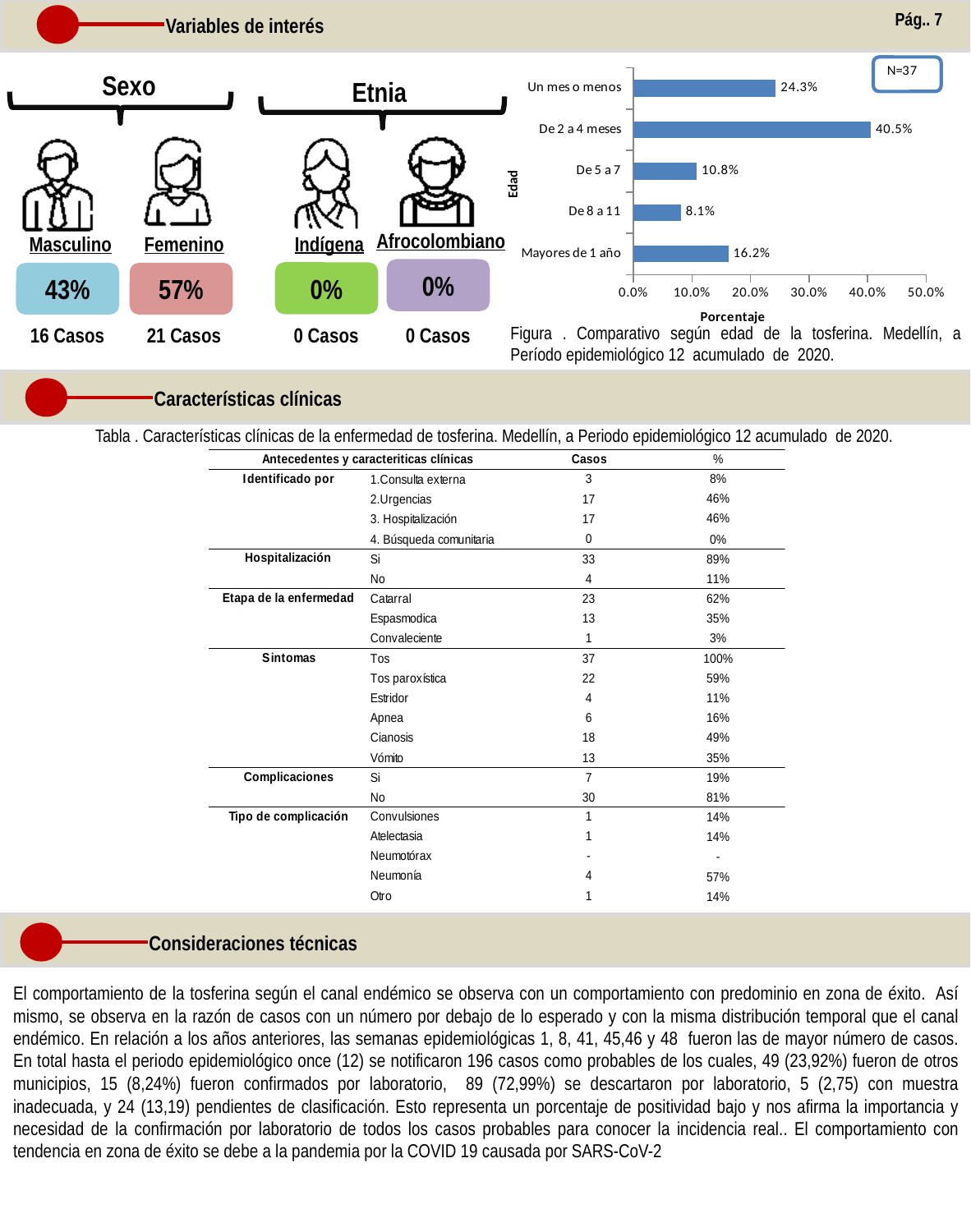
What kind of chart is used to show the distribution by age? Bar chart What is the value for 'Un mes o menos' in the age bar chart? 24.3% Which is larger in the age bar chart, 'De 5 a 7' or 'Mayores de 1 año'? Mayores de 1 año How many age categories are shown in the bar chart? 5 What sample size (N) is indicated on the age bar chart? N=37 What is the title of the horizontal axis in the age bar chart? Porcentaje What is the value for 'Mayores de 1 año' in the age bar chart? 16.2% Which age category has the highest value in the bar chart? De 2 a 4 meses What is the difference between the values for 'De 2 a 4 meses' and 'Un mes o menos' in the age bar chart? 16.2% Which age category has the lowest value in the bar chart? De 8 a 11 What is the value for 'De 8 a 11' in the age bar chart? 8.1% What is the value for 'De 2 a 4 meses' in the age bar chart? 40.5%